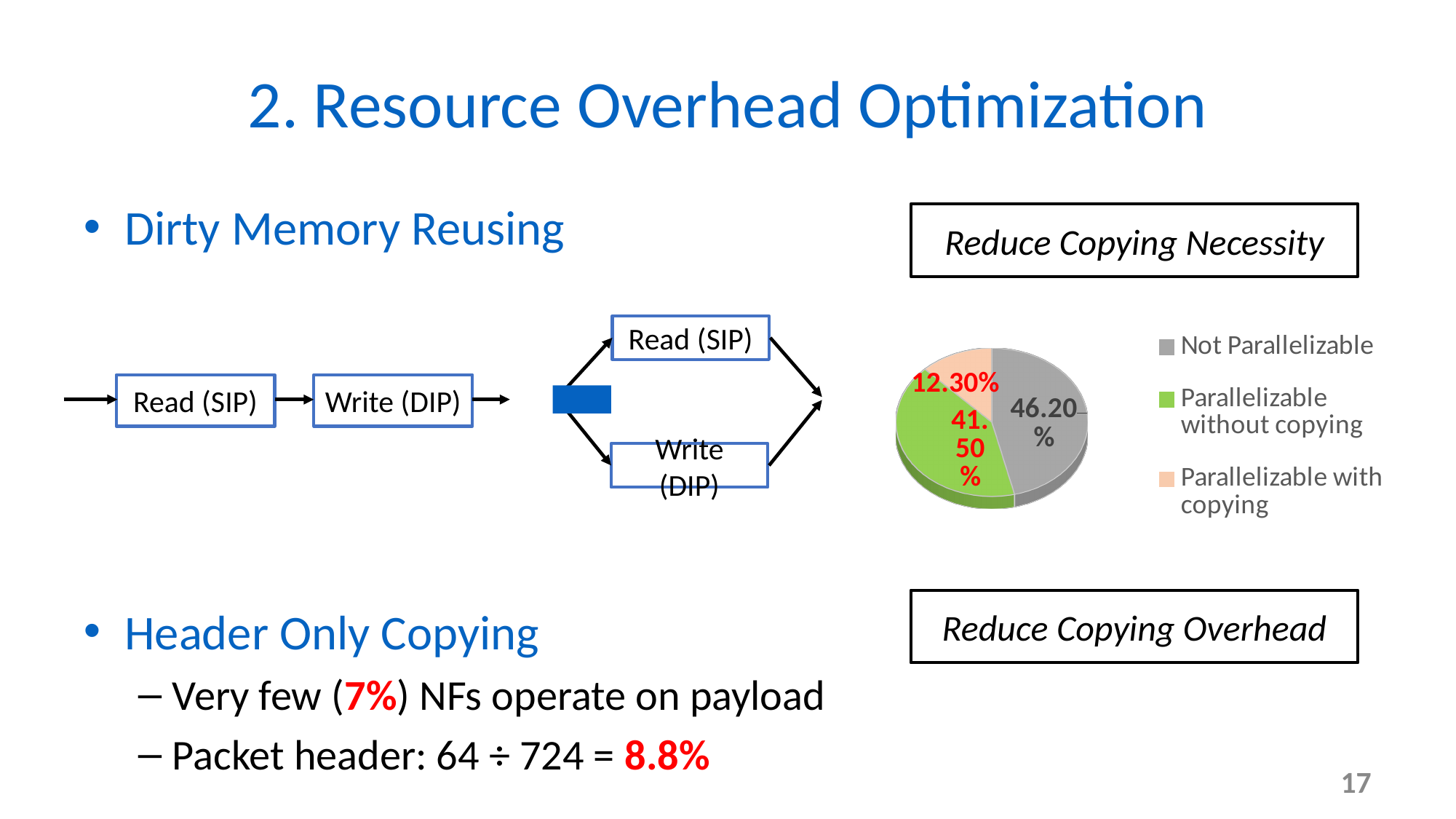
Which is larger: the Parallelizable without copying slice or the Parallelizable with copying slice? Parallelizable without copying What share of the pie is labelled Parallelizable without copying? 41.50% What colour is the Parallelizable without copying slice in the pie chart? green How many slices does the pie chart have? 3 Which slice of the pie chart is the largest? Not Parallelizable What is the difference between the Not Parallelizable share and the Parallelizable without copying share? 4.70% What share of the pie is labelled Not Parallelizable? 46.20% What share of the pie is labelled Parallelizable with copying? 12.30% Which slice of the pie chart is the smallest? Parallelizable with copying What colour is the Not Parallelizable slice in the pie chart? grey How many entries does the legend of the pie chart list? 3 What kind of chart is shown on the slide? pie chart